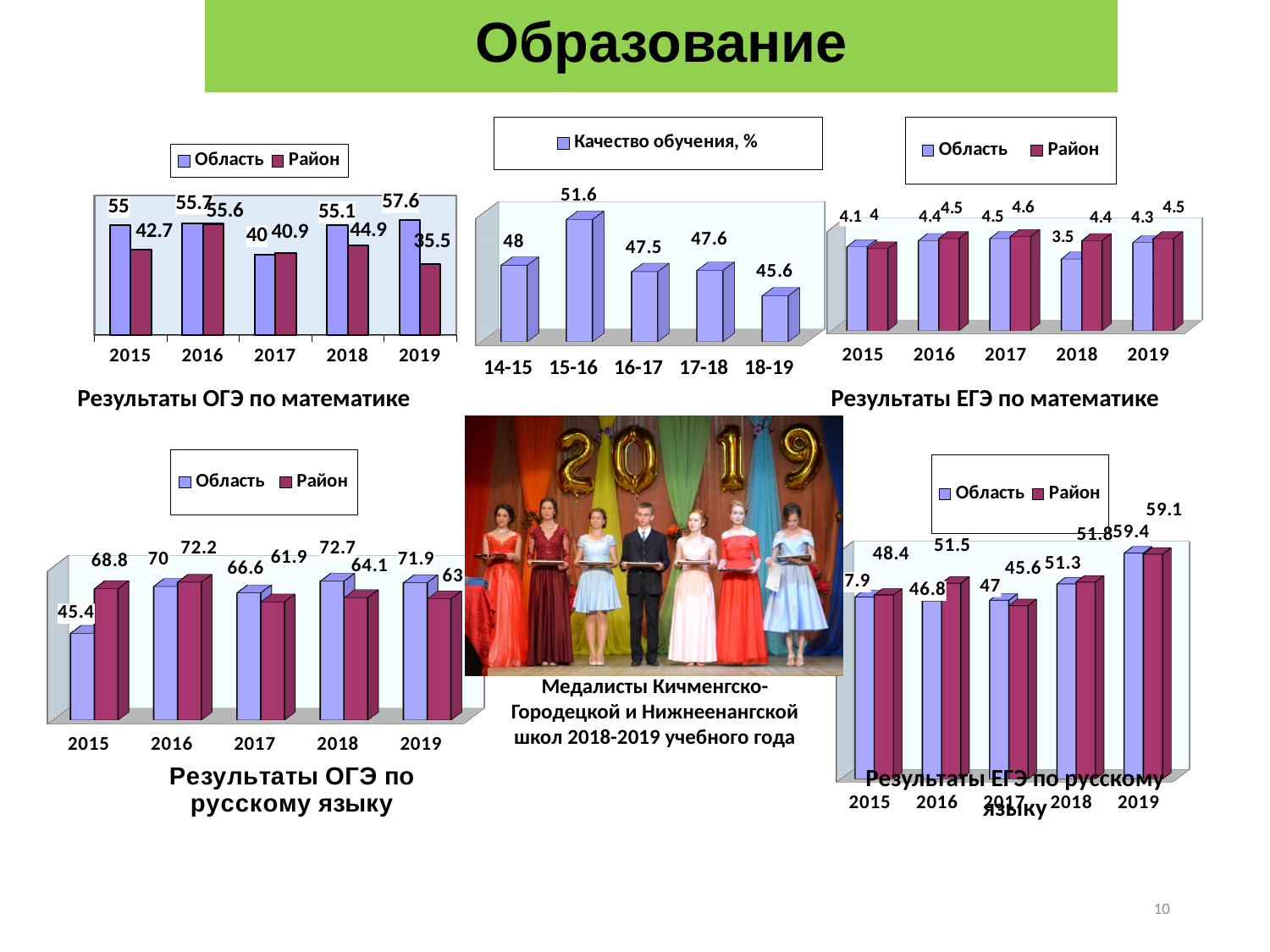
In the chart titled 'Результаты ЕГЭ по математике', what is the value for Область in 2018? 3.5 In the chart titled 'Результаты ОГЭ по математике', what is the value for Район in 2019? 35.5 How many bars are plotted in the chart titled 'Качество обучения, %'? 5 In the chart titled 'Результаты ОГЭ по русскому языку', what is the value for Область in 2015? 45.4 In the chart titled 'Результаты ЕГЭ по русскому языку', what is the value for Район in 2016? 51.5 In the chart titled 'Результаты ОГЭ по математике', which year has the highest value for Область? 2019 How many series does the legend list in the chart titled 'Результаты ЕГЭ по русскому языку'? 2 In the chart titled 'Результаты ОГЭ по русскому языку', which is larger in 2018, Область or Район? Область In the chart titled 'Результаты ОГЭ по математике', what is the difference between Область and Район in 2015? 12.3 In the chart titled 'Качество обучения, %', what is the value for 18-19? 45.6 In the chart titled 'Результаты ЕГЭ по математике', which year has the lowest value for Область? 2018 In the chart titled 'Качество обучения, %', which period has the highest value? 15-16